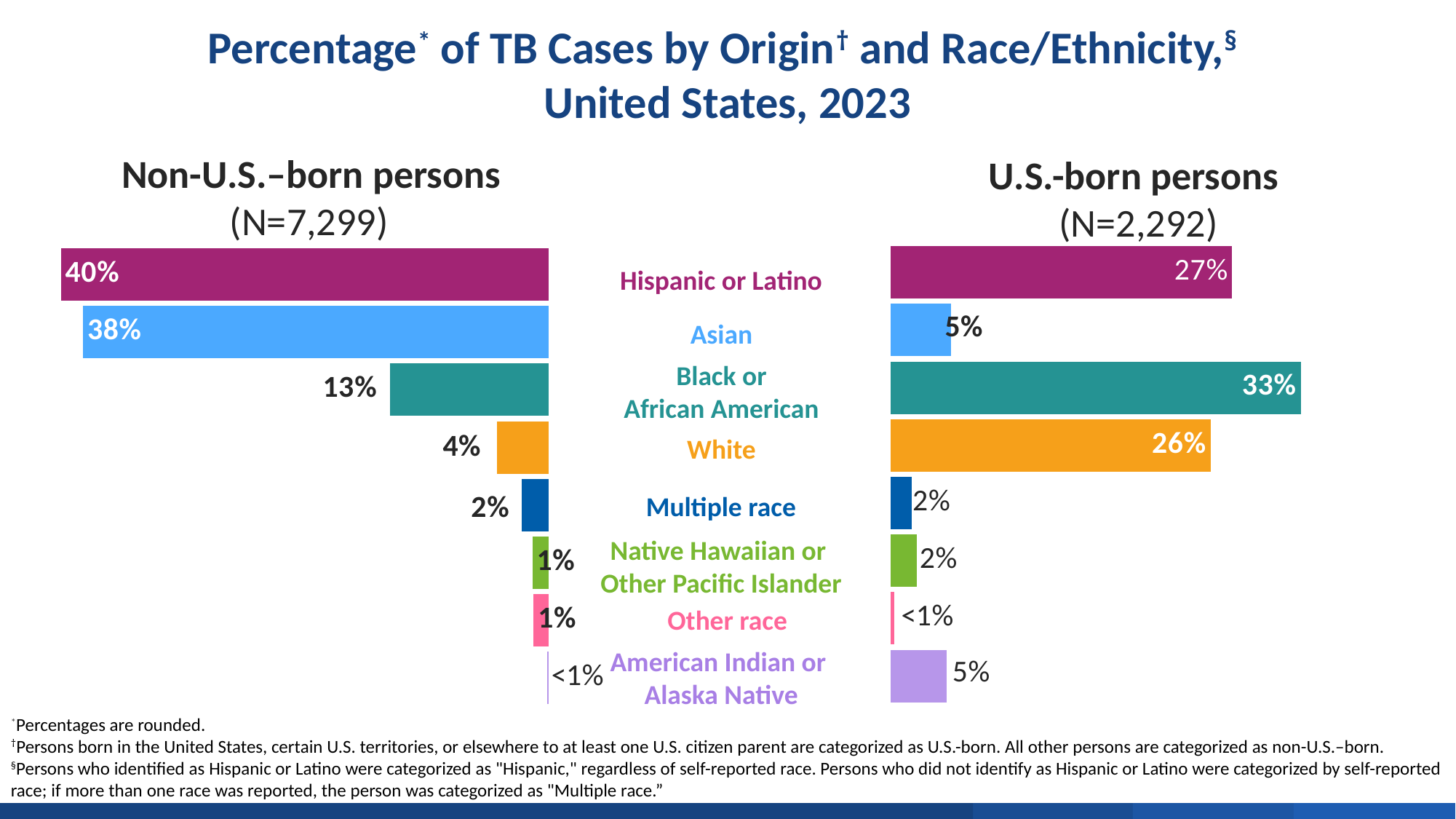
In the U.S.-born persons chart, which race/ethnicity category has the highest percentage? Black or African American In the U.S.-born persons chart, what percentage of TB cases is for White persons? 26% In the U.S.-born persons chart, what percentage of TB cases is for Black or African American persons? 33% What type of chart is used on this slide? Bar chart In the Non-U.S.-born persons chart, what percentage of TB cases is for Asian persons? 38% Is the percentage for Asian persons larger in the Non-U.S.-born persons chart or the U.S.-born persons chart? Non-U.S.-born persons In the Non-U.S.-born persons chart, what percentage of TB cases is for Hispanic or Latino persons? 40% In the U.S.-born persons chart, what is the difference between the Hispanic or Latino and Asian percentages? 22% In the Non-U.S.-born persons chart, what is the difference between the Asian and Black or African American percentages? 25% In the Non-U.S.-born persons chart, which race/ethnicity category has the highest percentage? Hispanic or Latino How many race/ethnicity categories are shown in each chart? 8 What is the N value shown for the U.S.-born persons chart? N=2,292